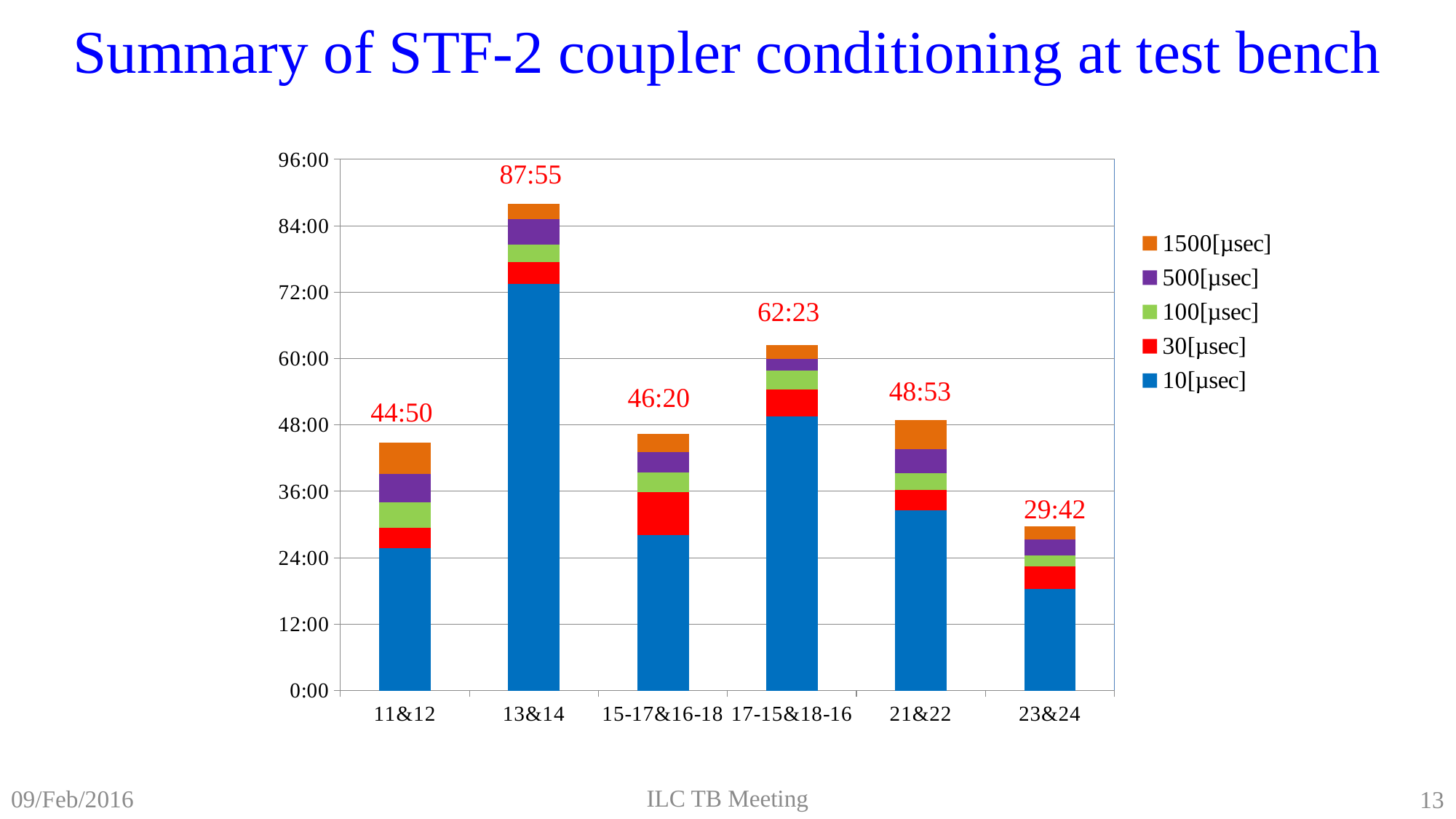
What kind of chart is shown on the slide? Stacked bar chart Which has a larger total, 15-17&16-18 or 21&22? 21&22 What is the difference between the total for 13&14 and the total for 11&12? 43:05 Is the 10[µsec] value for 23&24 greater or less than 24:00? less Which coupler pair has the lowest total conditioning time? 23&24 Which coupler pair has the highest total conditioning time? 13&14 What is the total value labeled for 17-15&18-16? 62:23 What is the total conditioning time shown for 13&14? 87:55 What is the total value labeled above the bar for 23&24? 29:42 How many coupler pairs (categories) are shown on the x axis? 6 How many series does the legend list? 5 What is the difference between the total for 21&22 and the total for 23&24? 19:11